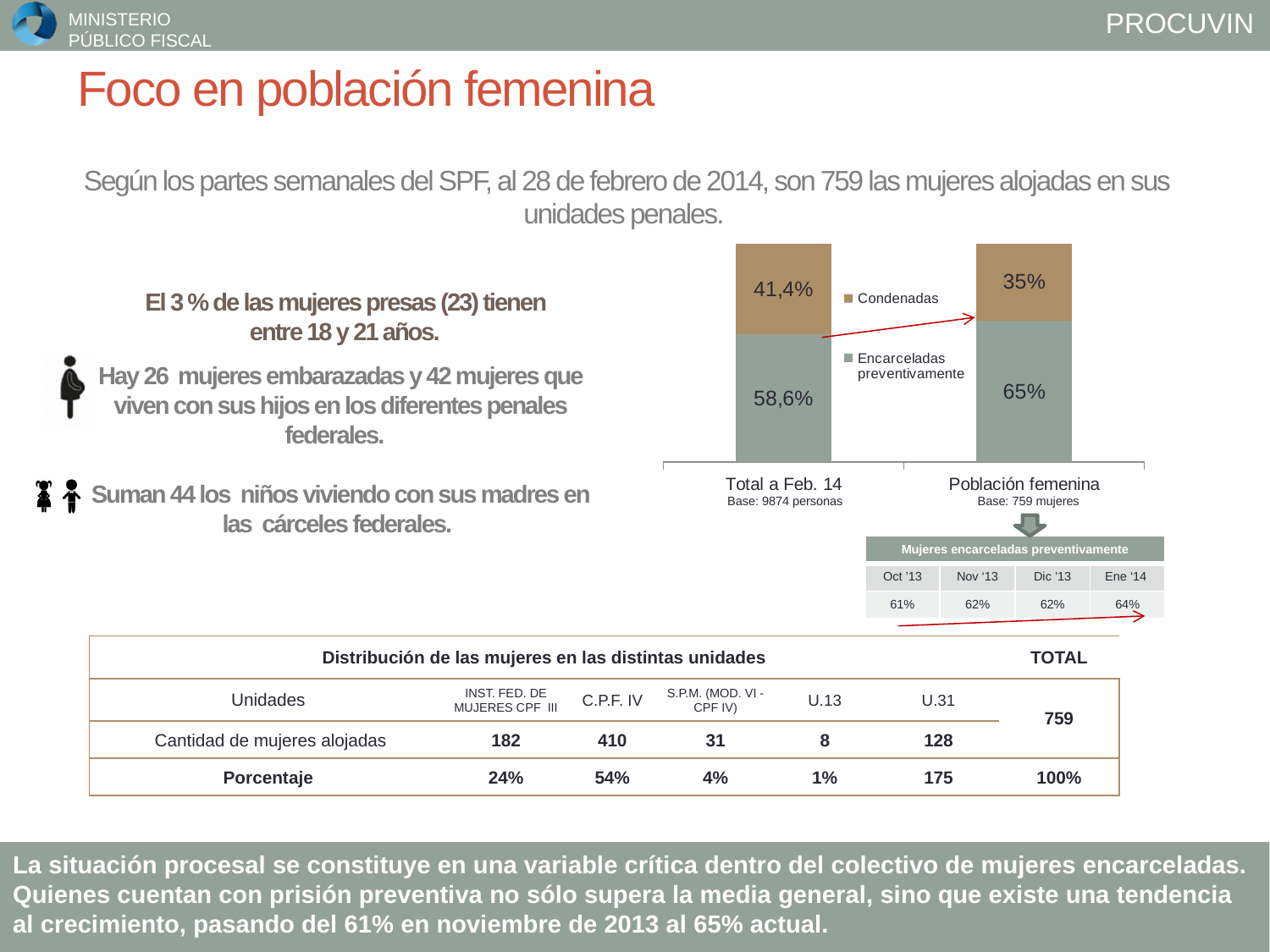
What is the difference between the Condenadas values for Total a Feb. 14 and Población femenina? 6,4 percentage points Which category has the higher value for Encarceladas preventivamente, Total a Feb. 14 or Población femenina? Población femenina What is the value for Condenadas in the Población femenina bar? 35% What base is stated under the Población femenina bar? Base: 759 mujeres Which category has the lowest value for Condenadas? Población femenina What kind of chart is shown on the slide? stacked bar chart What are the two series named in the chart legend? Condenadas and Encarceladas preventivamente How many series does the chart legend list? 2 What is the value for Encarceladas preventivamente in the Población femenina bar? 65% What is the value for Encarceladas preventivamente in the Total a Feb. 14 bar? 58,6% How many categories (bars) are plotted in the chart? 2 What is the value for Condenadas in the Total a Feb. 14 bar? 41,4%